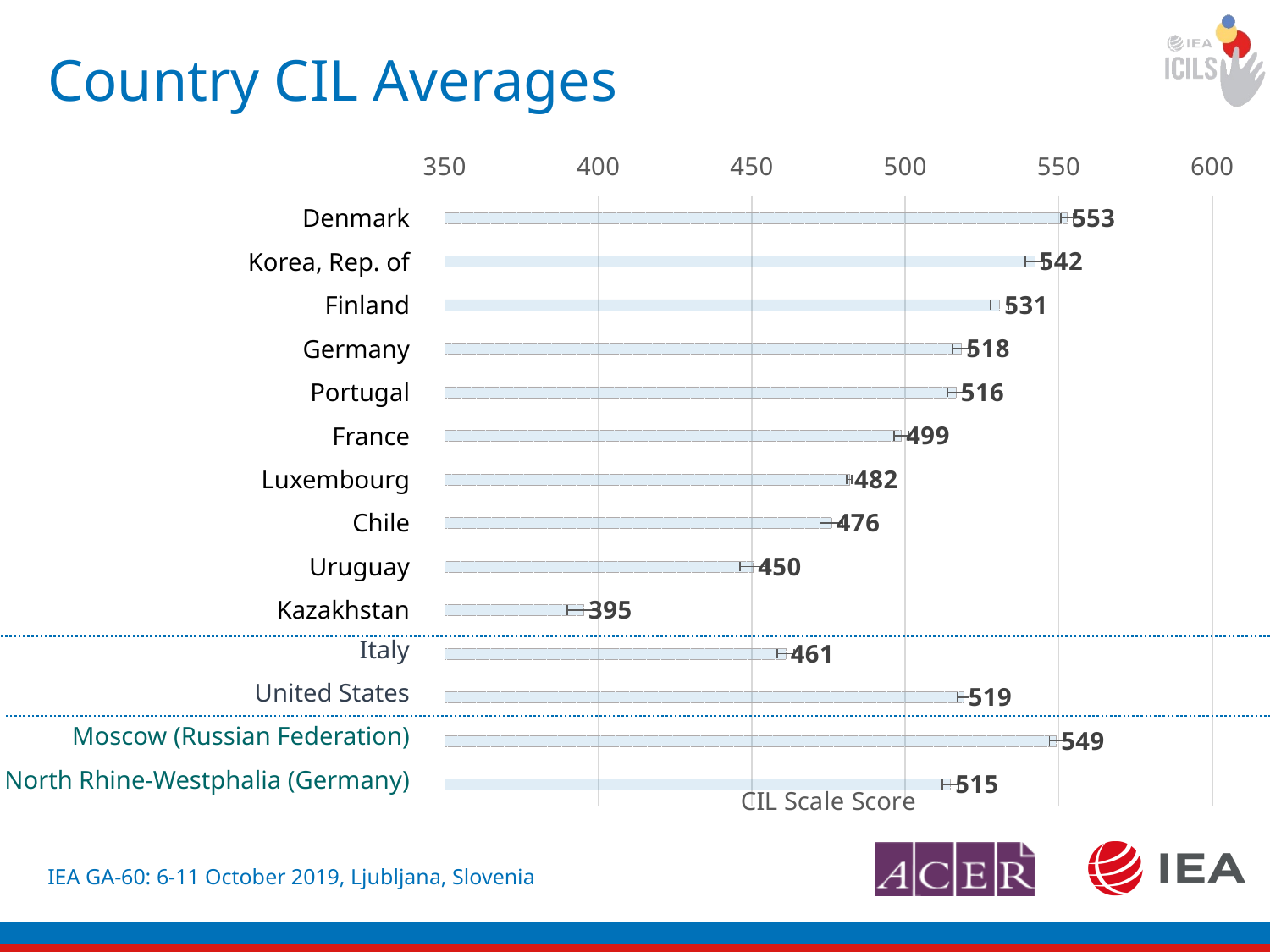
Is the CIL average score for Chile greater or less than 500? less Which country or region has the highest CIL average score? Denmark What is the difference between the CIL average scores of Denmark and Kazakhstan? 158 Which has a higher CIL average score, Italy or Uruguay? Italy Which country or region has the lowest CIL average score? Kazakhstan What is the CIL average score for Kazakhstan? 395 Which has a higher CIL average score, the United States or France? United States What is the CIL average score for Denmark? 553 What is the CIL average score for Moscow (Russian Federation)? 549 What kind of chart is shown on the slide? bar chart How many countries and regions are shown in the chart? 14 What is the difference between the CIL average scores of Germany and Portugal? 2